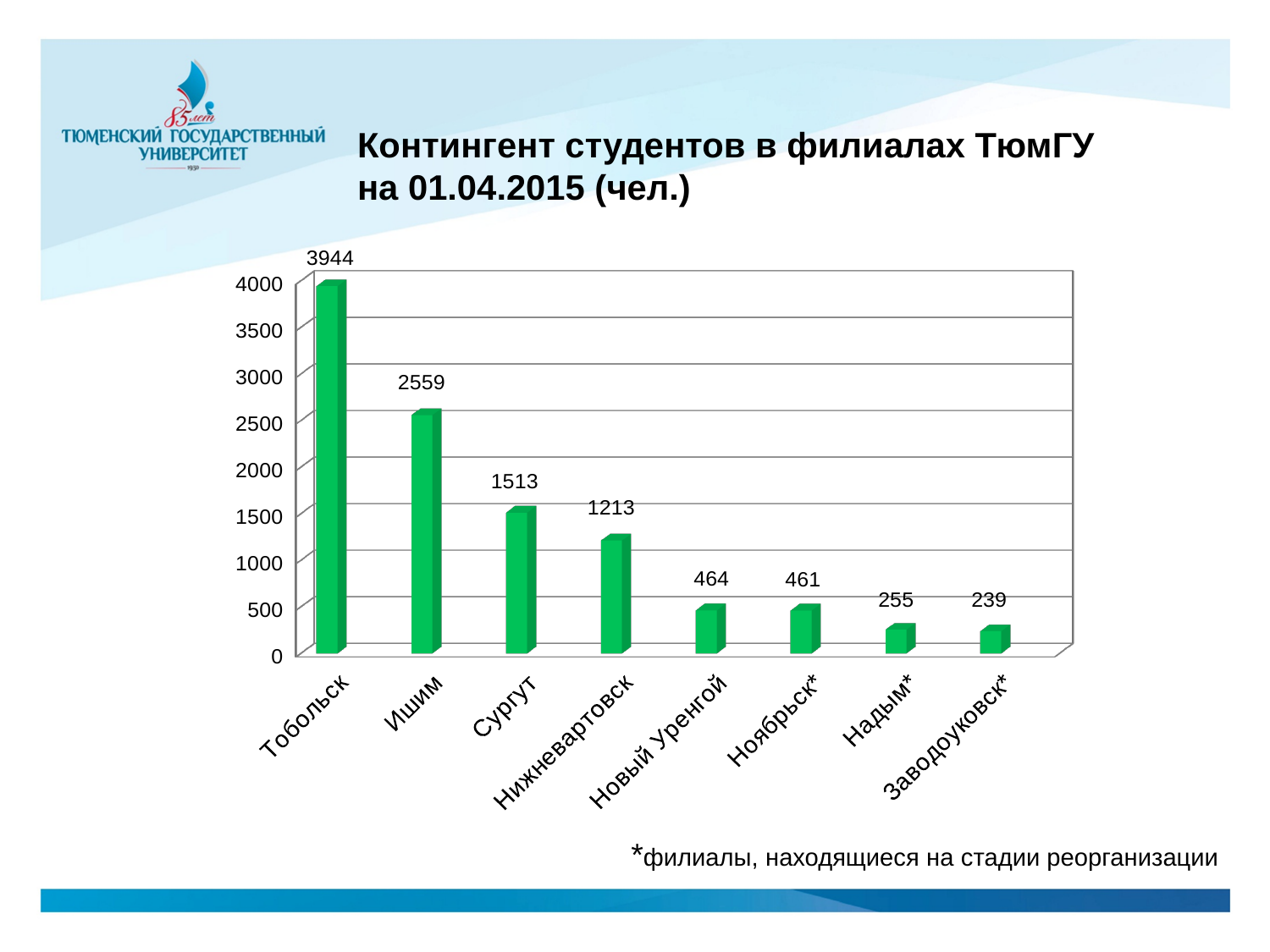
Which branch has more students, Ишим or Сургут? Ишим Is the value for Новый Уренгой greater or less than 500? less Which branch has the highest number of students? Тобольск What is the number of students at the Тобольск branch? 3944 Which branch has the lowest number of students? Заводоуковск* What is the difference in student numbers between Тобольск and Ишим? 1385 What is the number of students at the Нижневартовск branch? 1213 How many branches are shown in the chart? 8 What is the title of the chart? Контингент студентов в филиалах ТюмГУ на 01.04.2015 (чел.) What is the difference in student numbers between Сургут and Нижневартовск? 300 What type of chart is shown on the slide? bar chart What is the number of students at the Надым* branch? 255